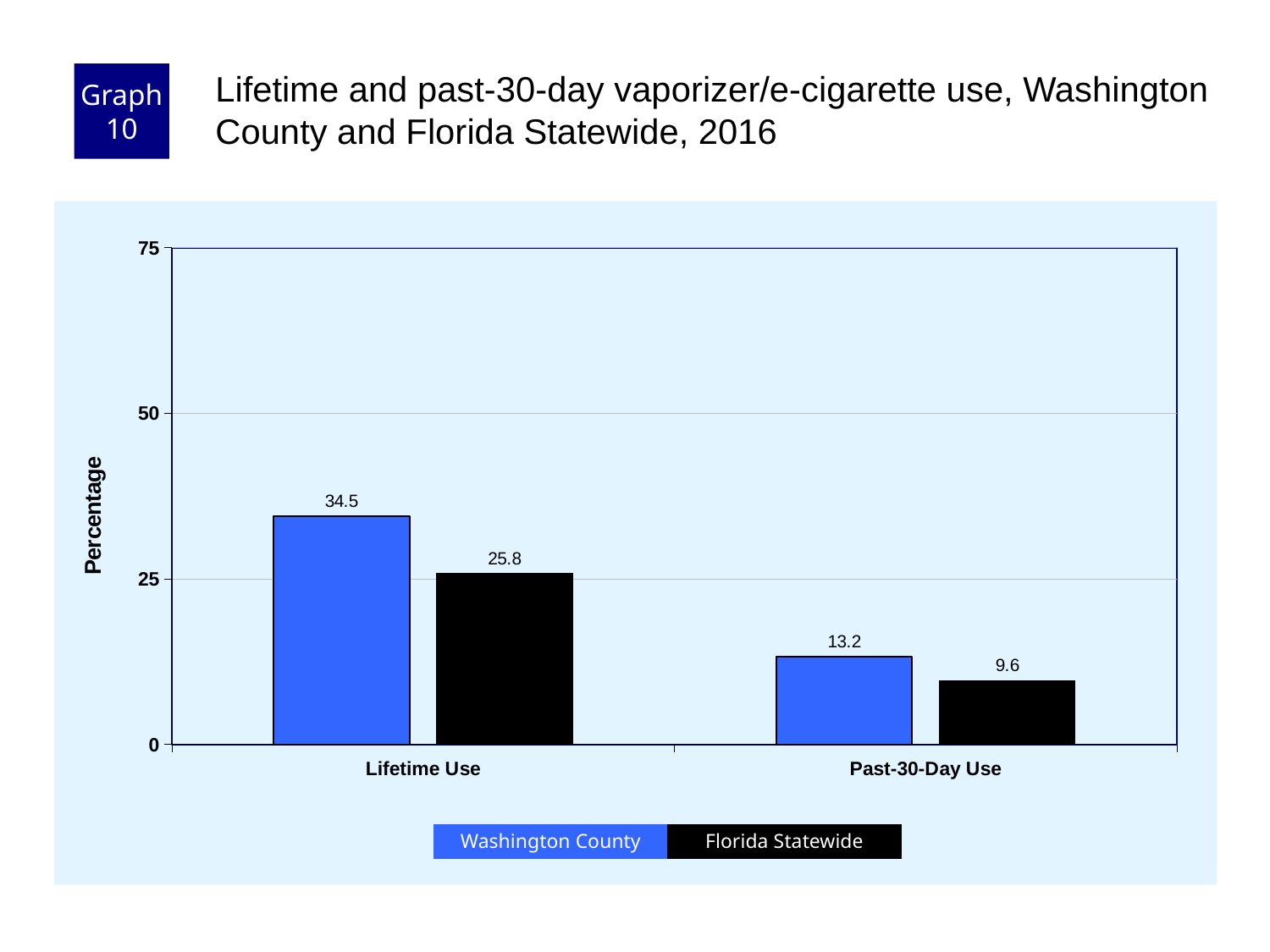
Which series has the highest value for Lifetime Use? Washington County Which is larger for Past-30-Day Use, Washington County or Florida Statewide? Washington County What is the value for Washington County for Lifetime Use? 34.5 How many series does the legend list? 2 How many categories are shown on the x axis? 2 What is the difference between Washington County and Florida Statewide for Lifetime Use? 8.7 What is the value for Florida Statewide for Lifetime Use? 25.8 Which bar has the lowest value on the chart? Florida Statewide, Past-30-Day Use What is the value for Florida Statewide for Past-30-Day Use? 9.6 What kind of chart is shown on the slide? Bar chart What is the value for Washington County for Past-30-Day Use? 13.2 What is the difference between Washington County and Florida Statewide for Past-30-Day Use? 3.6